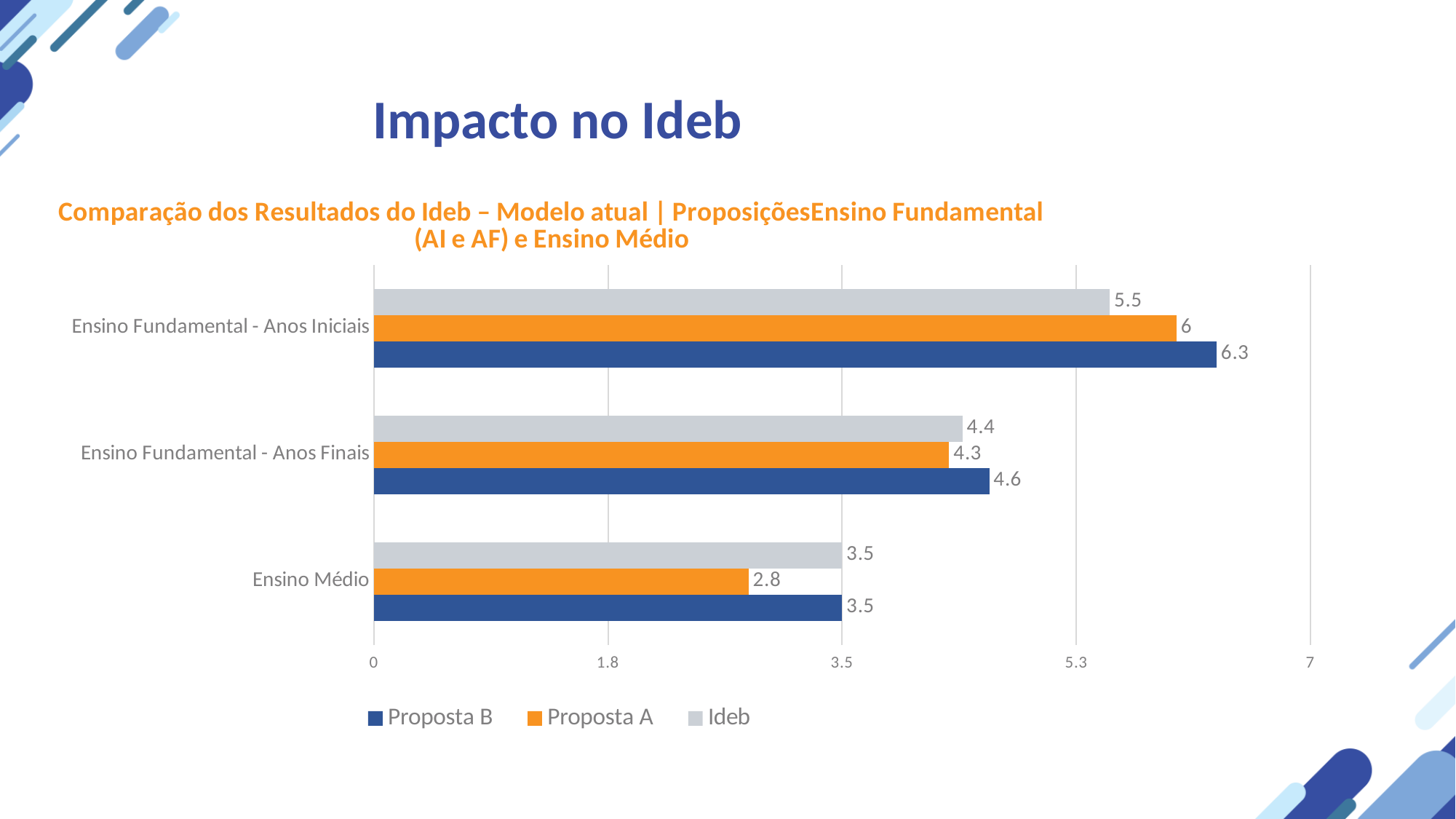
What kind of chart is shown on the slide? Bar chart What is the Ideb value for Ensino Fundamental - Anos Finais? 4.4 For Ensino Fundamental - Anos Finais, which is larger: Proposta A or Ideb? Ideb Which category has the lowest Proposta A value? Ensino Médio How many categories are shown on the chart? 3 What is the Proposta A value for Ensino Médio? 2.8 What is the Proposta B value for Ensino Fundamental - Anos Iniciais? 6.3 What is the difference between the Proposta B and Ideb values for Ensino Fundamental - Anos Iniciais? 0.8 Which series is shown in orange in the legend? Proposta A Is the Proposta A value for Ensino Fundamental - Anos Iniciais greater or less than 5.3? greater How many series does the legend list? 3 Which category has the highest Proposta B value? Ensino Fundamental - Anos Iniciais